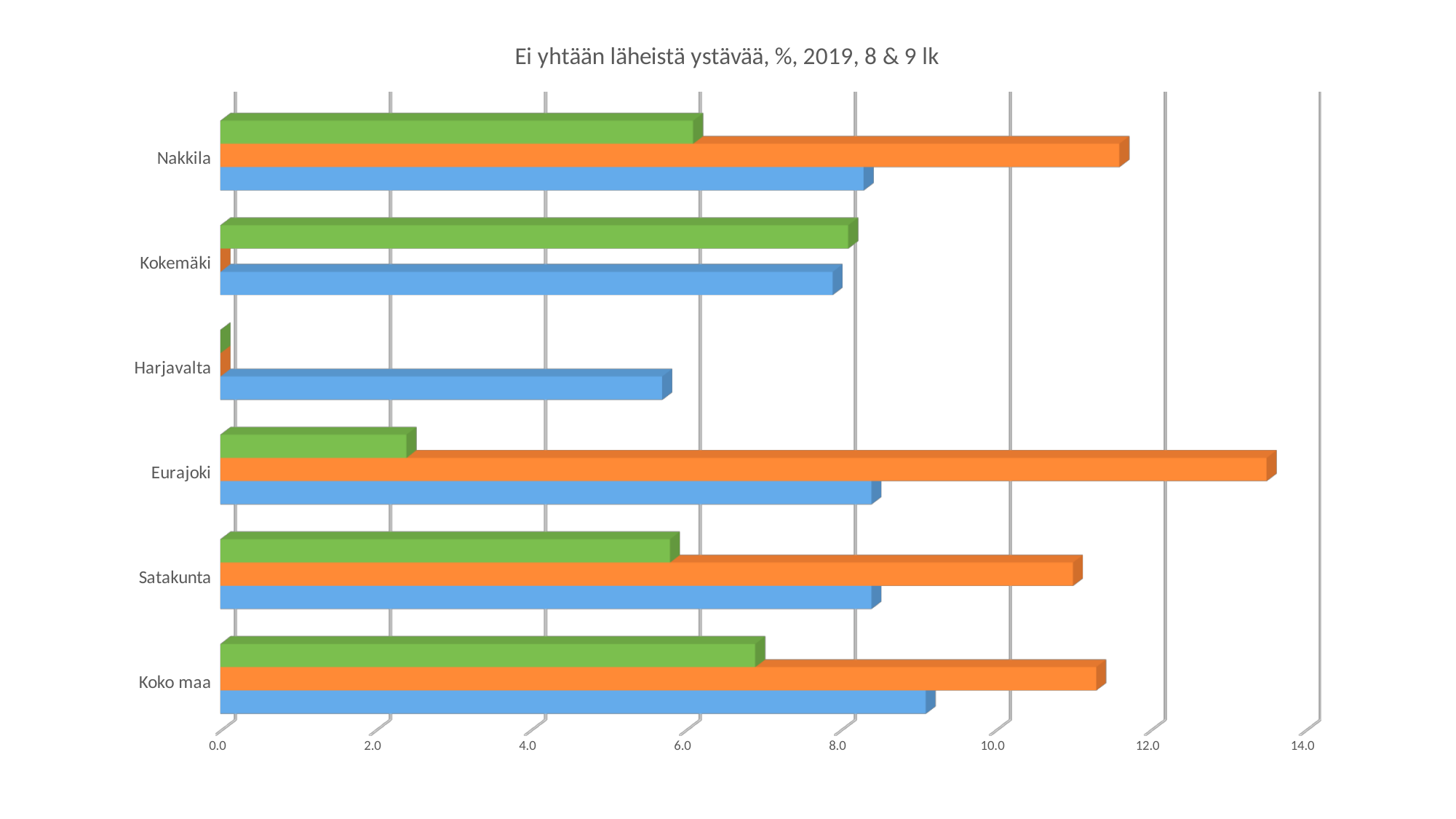
Which is larger, the orange bar for Eurajoki or the orange bar for Nakkila? Eurajoki What kind of chart is shown on the slide? bar chart Which category has the longest orange bar? Eurajoki How many differently coloured bars are shown for each category? 3 Is the orange bar for Nakkila greater or less than 10.0? greater How many categories are shown on the vertical axis of the chart? 6 Which is larger, the green bar for Kokemäki or the green bar for Eurajoki? Kokemäki Is the green bar for Eurajoki greater or less than 4.0? less Is the blue bar for Harjavalta greater or less than 6.0? less What is the title of the chart? Ei yhtään läheistä ystävää, %, 2019, 8 & 9 lk